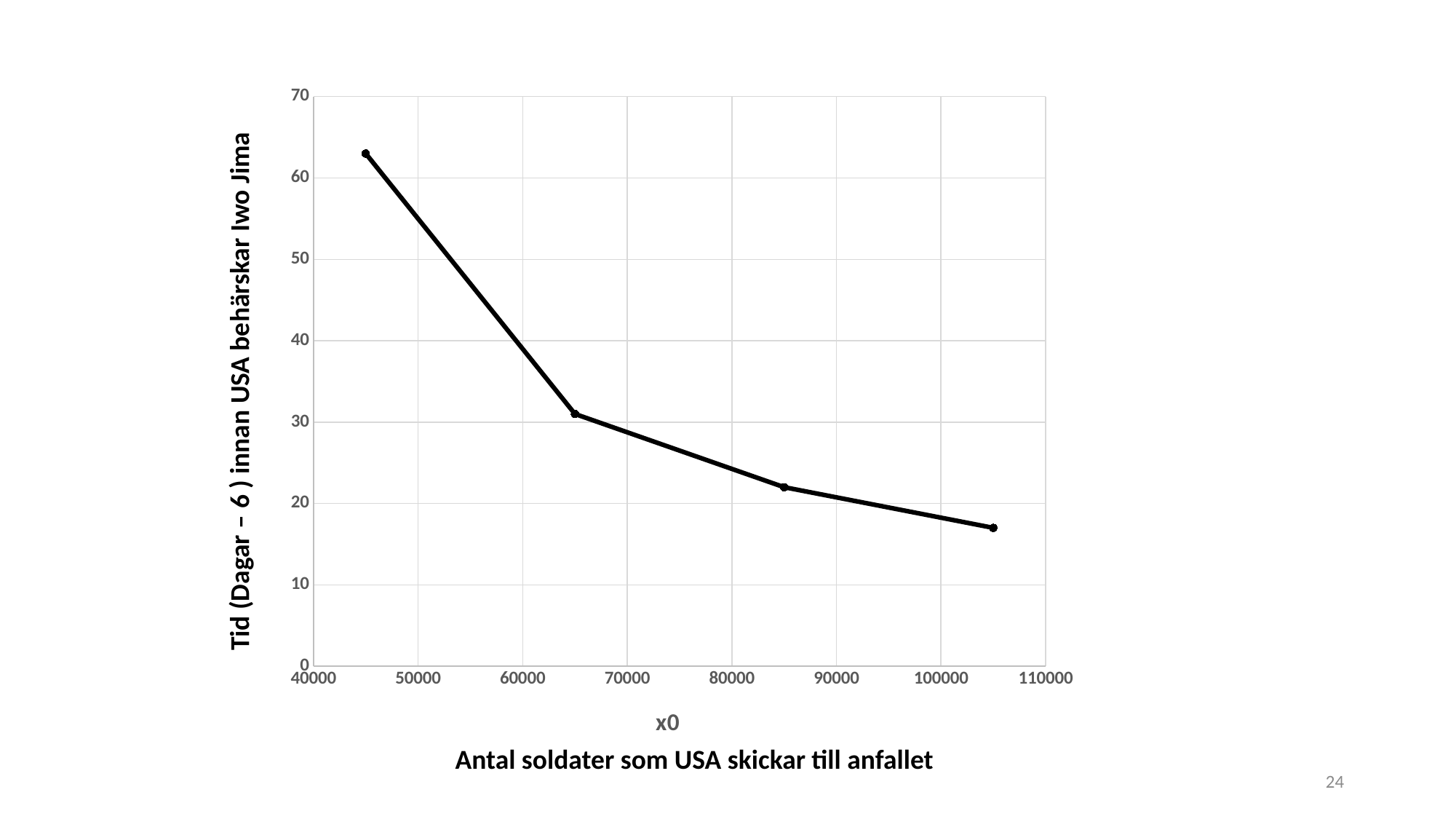
What is the title of the x axis? Antal soldater som USA skickar till anfallet Is the value of the leftmost point greater or less than 60? greater What kind of chart is shown on the slide? line chart Which point has the highest value, the leftmost or the rightmost? the leftmost Is the value of the second point from the left greater or less than 40? less Is the value of the third point from the left greater or less than 20? greater Do the values rise or fall as the number of soldiers on the x axis increases? fall How many data points are plotted on the line? 4